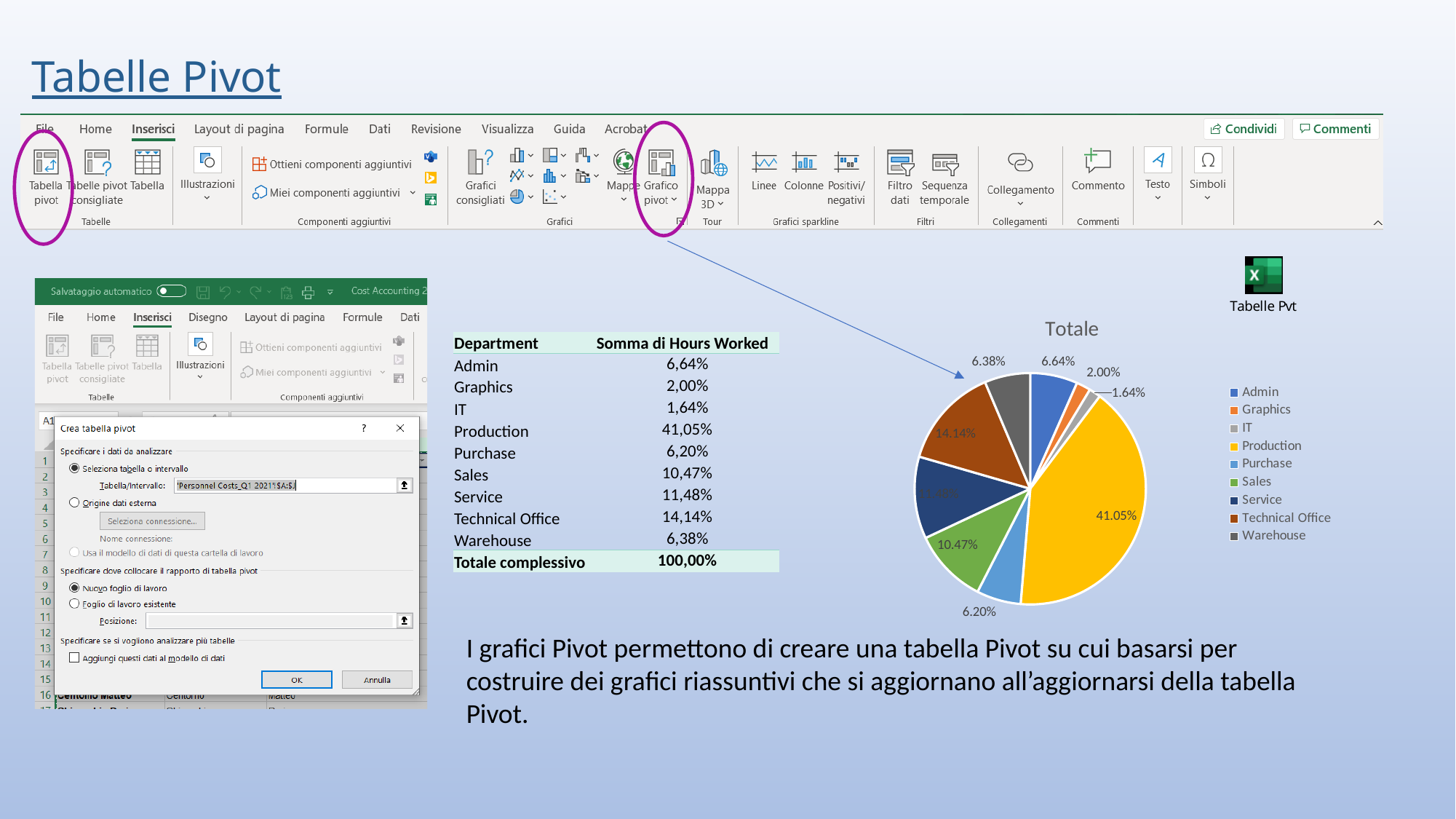
In the pie chart titled "Totale", which department has the largest slice? Production In the pie chart titled "Totale", what is the value shown for Technical Office? 14.14% In the pie chart titled "Totale", what is the difference between the Production and Technical Office values? 26.91% In the pie chart titled "Totale", what is the value shown for IT? 1.64% In the pie chart titled "Totale", which slice is larger, Sales or Purchase? Sales In the pie chart titled "Totale", which department has the smallest slice? IT In the pie chart titled "Totale", what colour is the Production slice? yellow In the pie chart titled "Totale", what is the value shown for Production? 41.05% In the pie chart titled "Totale", what is the value shown for Sales? 10.47% In the pie chart titled "Totale", what is the value shown for Warehouse? 6.38% How many departments are listed in the legend of the pie chart titled "Totale"? 9 What kind of chart is the chart titled "Totale"? pie chart